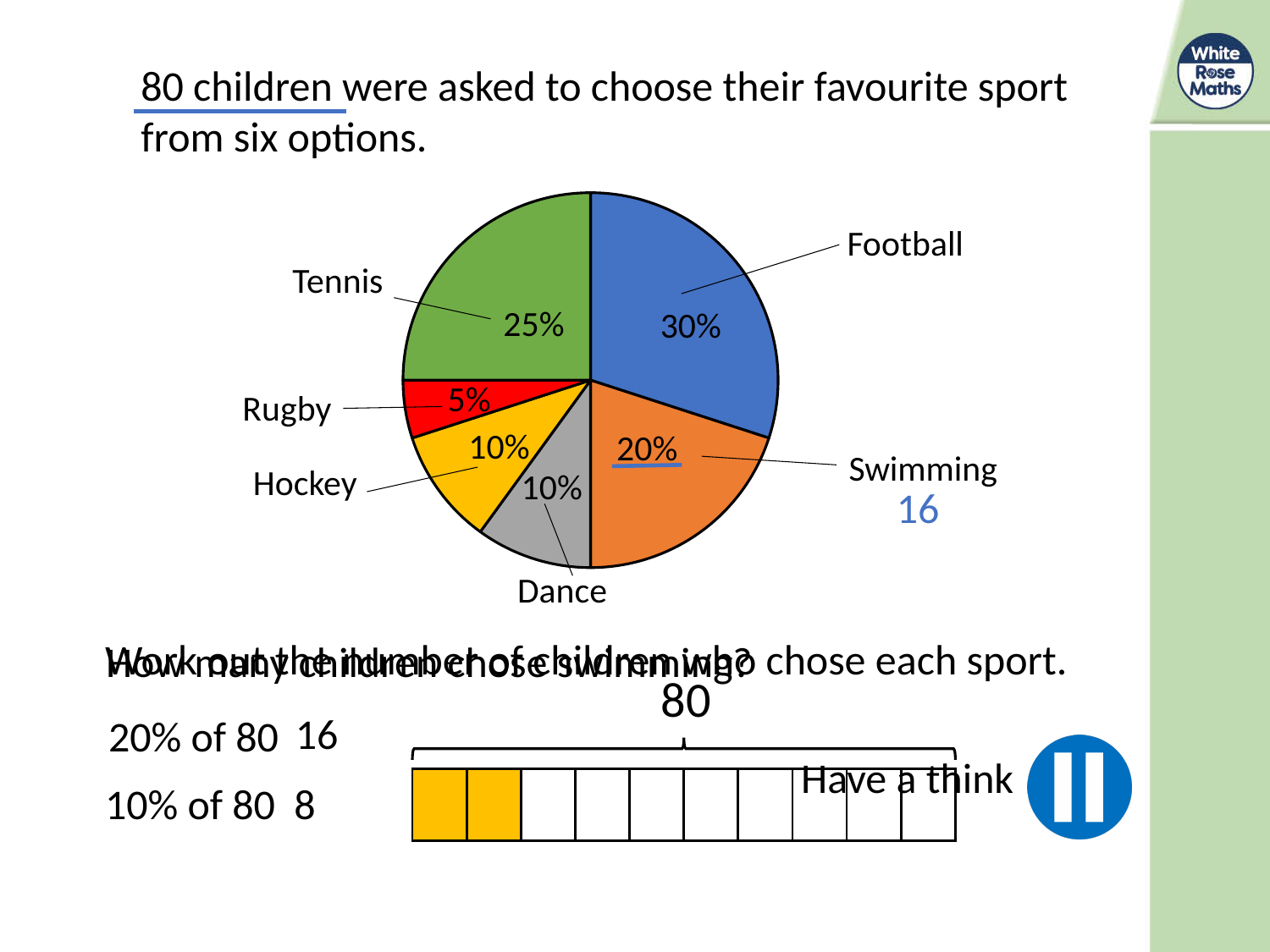
What type of chart is shown on the slide? Pie chart Which sport has the largest share of the pie chart? Football Which has a larger share, Swimming or Hockey? Swimming What percentage of children chose Swimming? 20% What percentage of children chose Football? 30% What percentage of children chose Rugby? 5% How many sports are shown in the pie chart? 6 What percentage of children chose Tennis? 25% What is the difference in percentage between Football and Tennis? 5% What colour is the Football slice of the pie chart? Blue What is the combined percentage for Hockey and Dance? 20% Which sport has the smallest share of the pie chart? Rugby